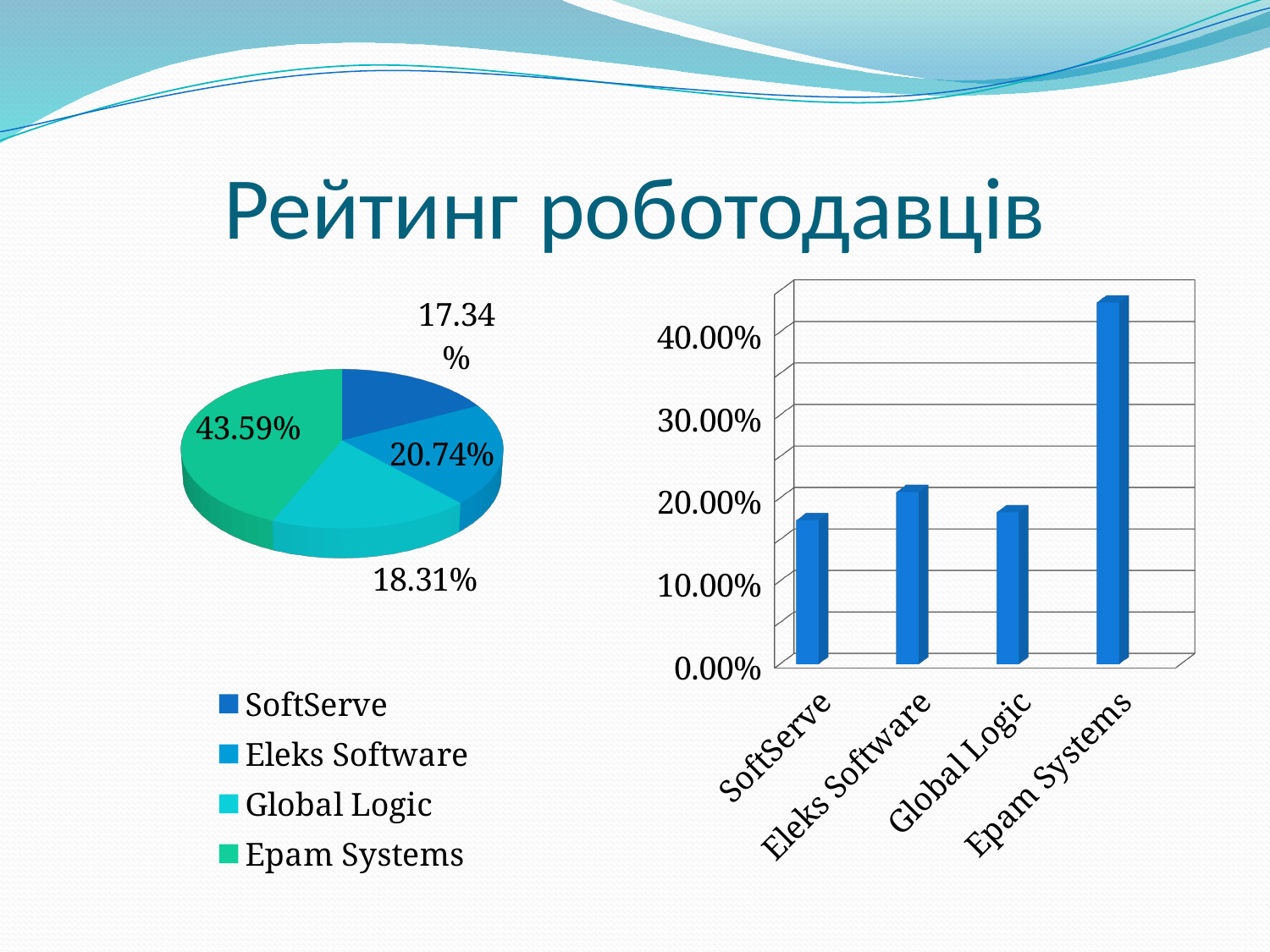
What kind of chart is shown on the right side of the slide? Bar chart In the bar chart on the right, which company has the tallest bar? Epam Systems In the pie chart on the left, which company has the smallest slice? SoftServe In the pie chart on the left, what share does Epam Systems have? 43.59% In the pie chart on the left, which is larger, the share of Eleks Software or the share of Global Logic? Eleks Software In the pie chart on the left, what share does Global Logic have? 18.31% In the pie chart on the left, which company has the largest slice? Epam Systems How many entries does the legend of the pie chart on the left list? 4 In the bar chart on the right, is the value for Epam Systems greater or less than 40.00%? greater In the pie chart on the left, what share does Eleks Software have? 20.74% In the pie chart on the left, what is the difference between the shares of Epam Systems and Eleks Software? 22.85% In the pie chart on the left, what share does SoftServe have? 17.34%